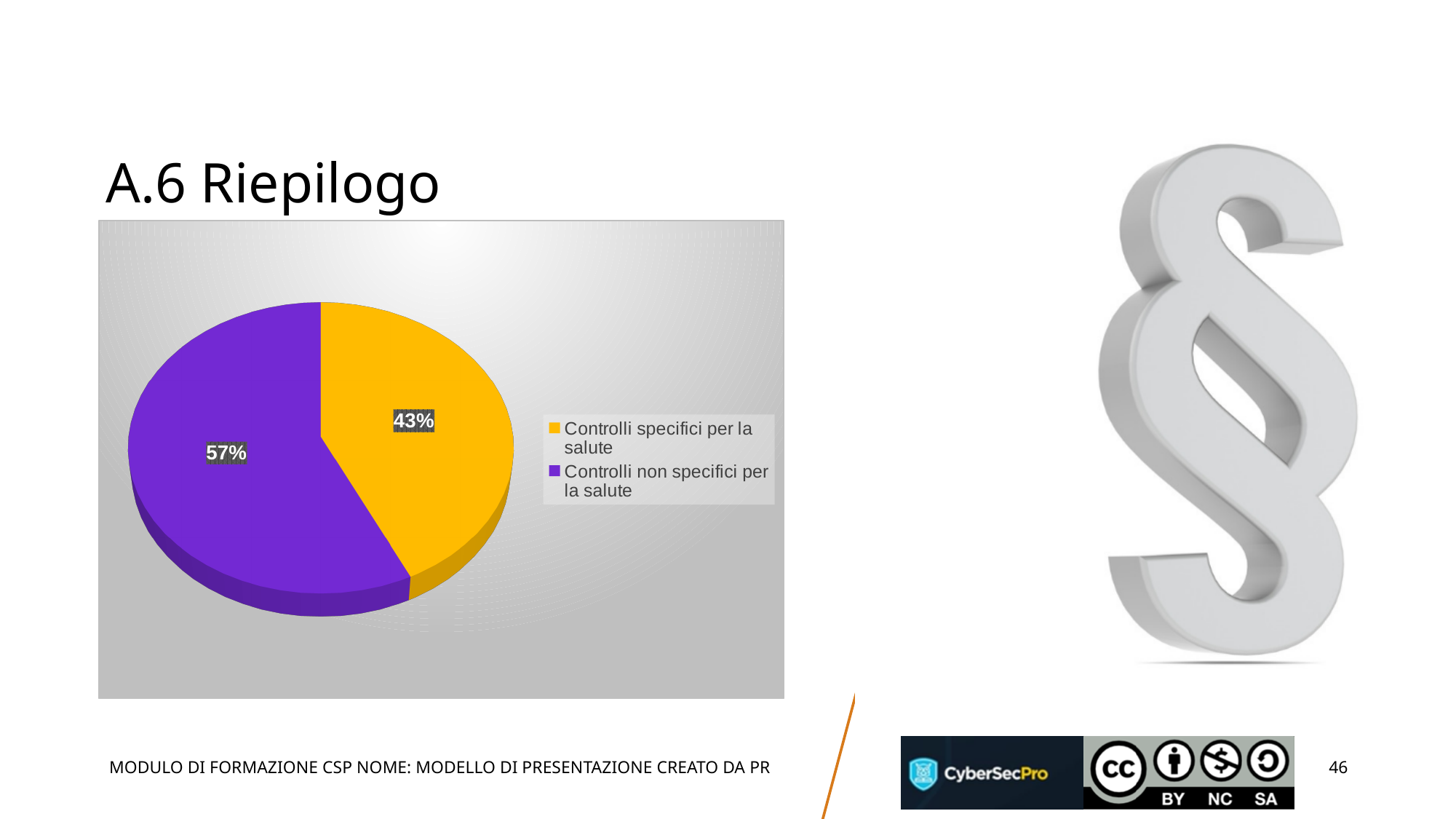
What share of the pie is 'Controlli specifici per la salute'? 43% How many entries does the legend list? 2 What kind of chart is shown on the slide? pie chart Which slice is the smallest? Controlli specifici per la salute What is the difference in percentage points between 'Controlli non specifici per la salute' and 'Controlli specifici per la salute'? 14 What share of the pie is 'Controlli non specifici per la salute'? 57% What colour is the 'Controlli non specifici per la salute' slice? purple What colour is the 'Controlli specifici per la salute' slice? yellow Which is larger: 'Controlli specifici per la salute' or 'Controlli non specifici per la salute'? Controlli non specifici per la salute How many slices does the pie chart have? 2 Which slice is the largest? Controlli non specifici per la salute